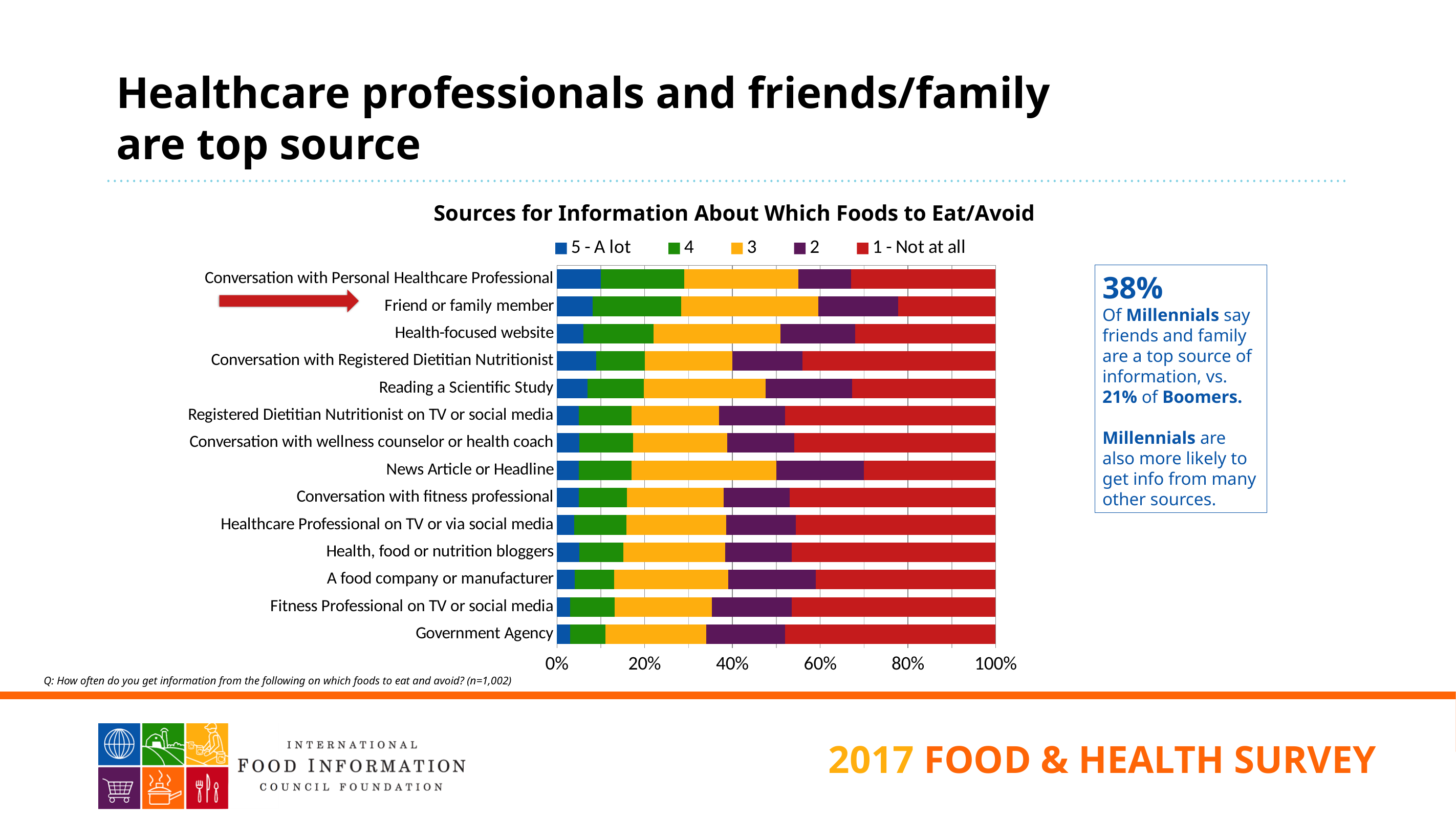
How many series does the chart legend list? 5 Which category has the smallest '1 - Not at all' segment? Friend or family member Is the '5 - A lot' share for Conversation with Personal Healthcare Professional greater or less than 20%? less What kind of chart is shown on the slide? Stacked bar chart Which has a larger '5 - A lot' share: Conversation with Personal Healthcare Professional or Government Agency? Conversation with Personal Healthcare Professional Is the combined '5 - A lot' and '4' share for Friend or family member greater or less than 20%? greater What is the title of the chart? Sources for Information About Which Foods to Eat/Avoid How many information sources (categories) are listed on the chart? 14 Which has a larger '1 - Not at all' share: Friend or family member or Government Agency? Government Agency Is the '1 - Not at all' share for Friend or family member greater or less than 40%? less Which legend entry is shown in red? 1 - Not at all